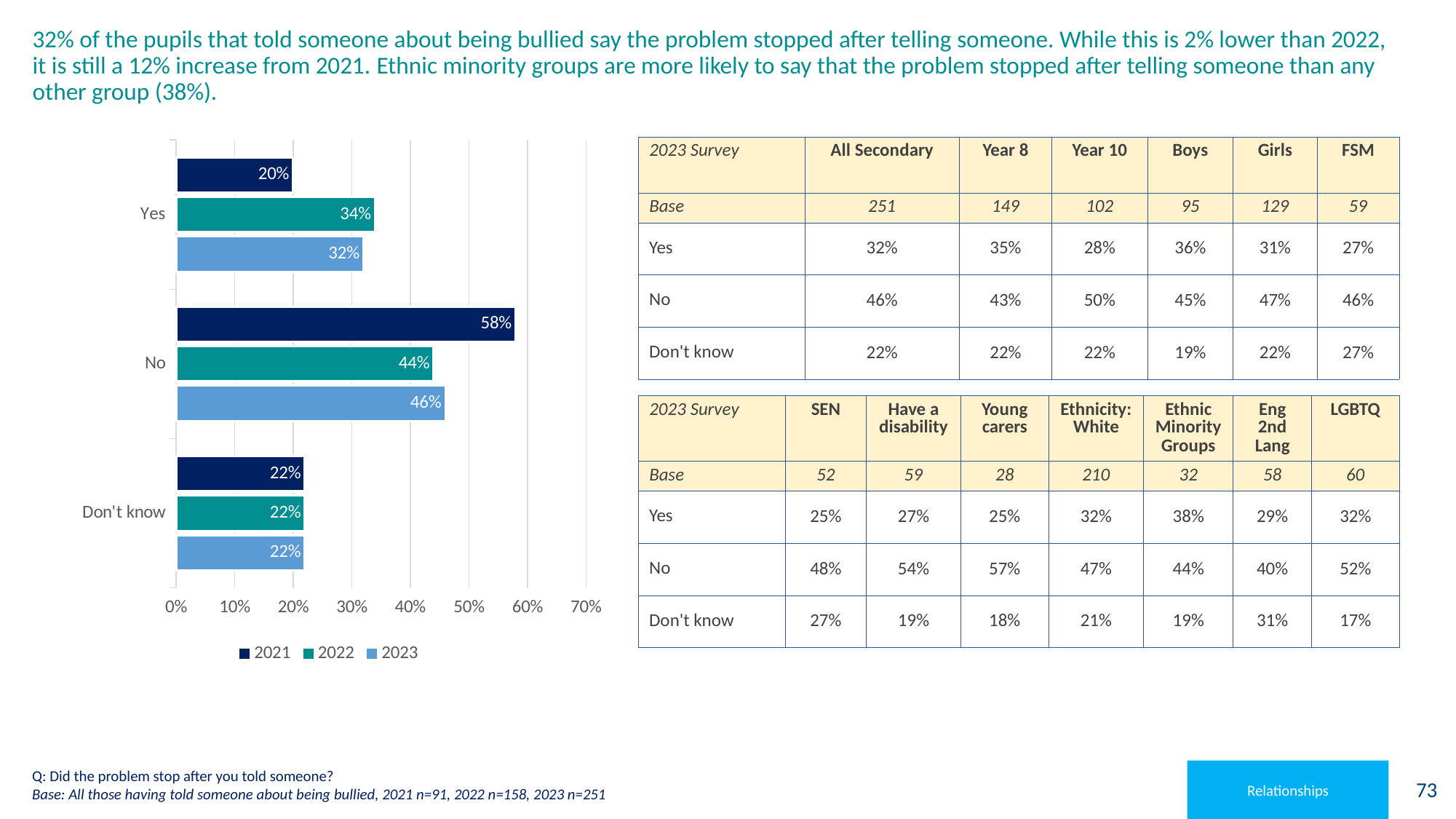
Which category has the lowest value in the 2022 series? Don't know Which is larger for 'Yes': the 2022 value or the 2023 value? 2022 What is the difference between the 2022 and 2023 values for 'Yes'? 2% What is the difference between the 2021 and 2022 values for 'No'? 14% Which category has the highest value in the 2021 series? No What is the value for 'Yes' in the 2021 series? 20% What is the value for 'No' in the 2023 series? 46% How many categories are shown on the chart? 3 Which series is shown in the darkest blue colour in the legend? 2021 What is the value for 'Don't know' in the 2022 series? 22% How many series does the legend list? 3 What kind of chart is shown on the slide? Bar chart